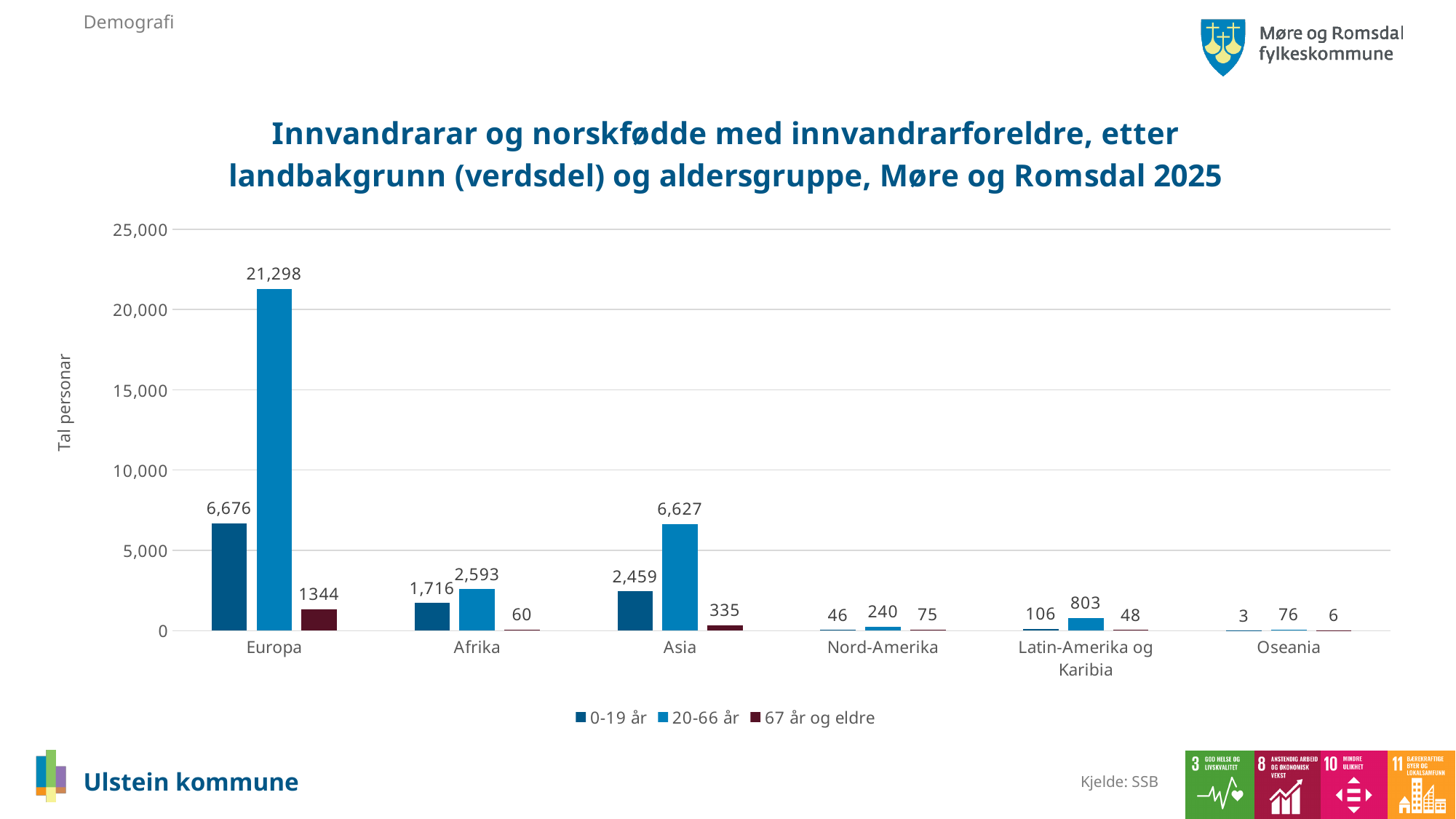
What is the value for the 67 år og eldre group for Asia? 335 What is the value for the 0-19 år group for Latin-Amerika og Karibia? 106 What is the value for the 20-66 år group for Europa? 21,298 Which region has the highest value for the 20-66 år group? Europa How many series does the legend list? 3 What is the difference between the 20-66 år values for Europa and Asia? 14,671 What type of chart is shown on the slide? bar chart Which is larger: the 20-66 år value for Latin-Amerika og Karibia or for Nord-Amerika? Latin-Amerika og Karibia Is the value for the 20-66 år group for Europa greater or less than 20,000? greater What is the label of the y axis? Tal personar How many world regions (categories) are shown on the x axis? 6 Which region has the lowest value for the 0-19 år group? Oseania